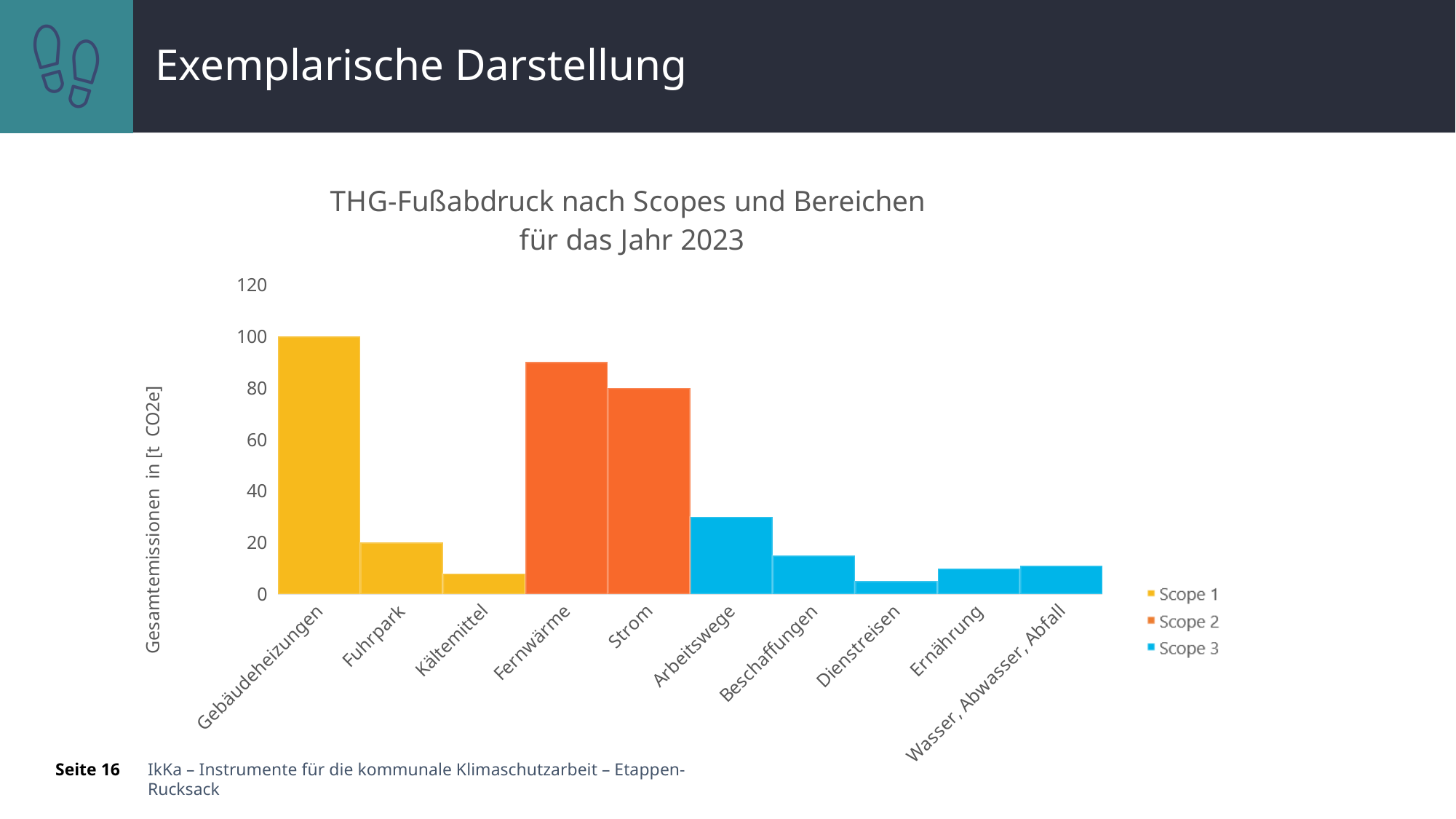
Is the value for Fernwärme greater or less than 80? greater What type of chart is shown on the slide? bar chart How many categories are shown on the x axis? 10 Which is larger, the value for Arbeitswege or the value for Beschaffungen? Arbeitswege What is the value for Gebäudeheizungen? 100 Which category has the highest value? Gebäudeheizungen What is the value for Fuhrpark? 20 What is the value for Strom? 80 What is the difference between the values for Gebäudeheizungen and Strom? 20 Which is larger, the value for Fernwärme or the value for Strom? Fernwärme How many series does the legend list? 3 Is the value for Dienstreisen greater or less than 20? less